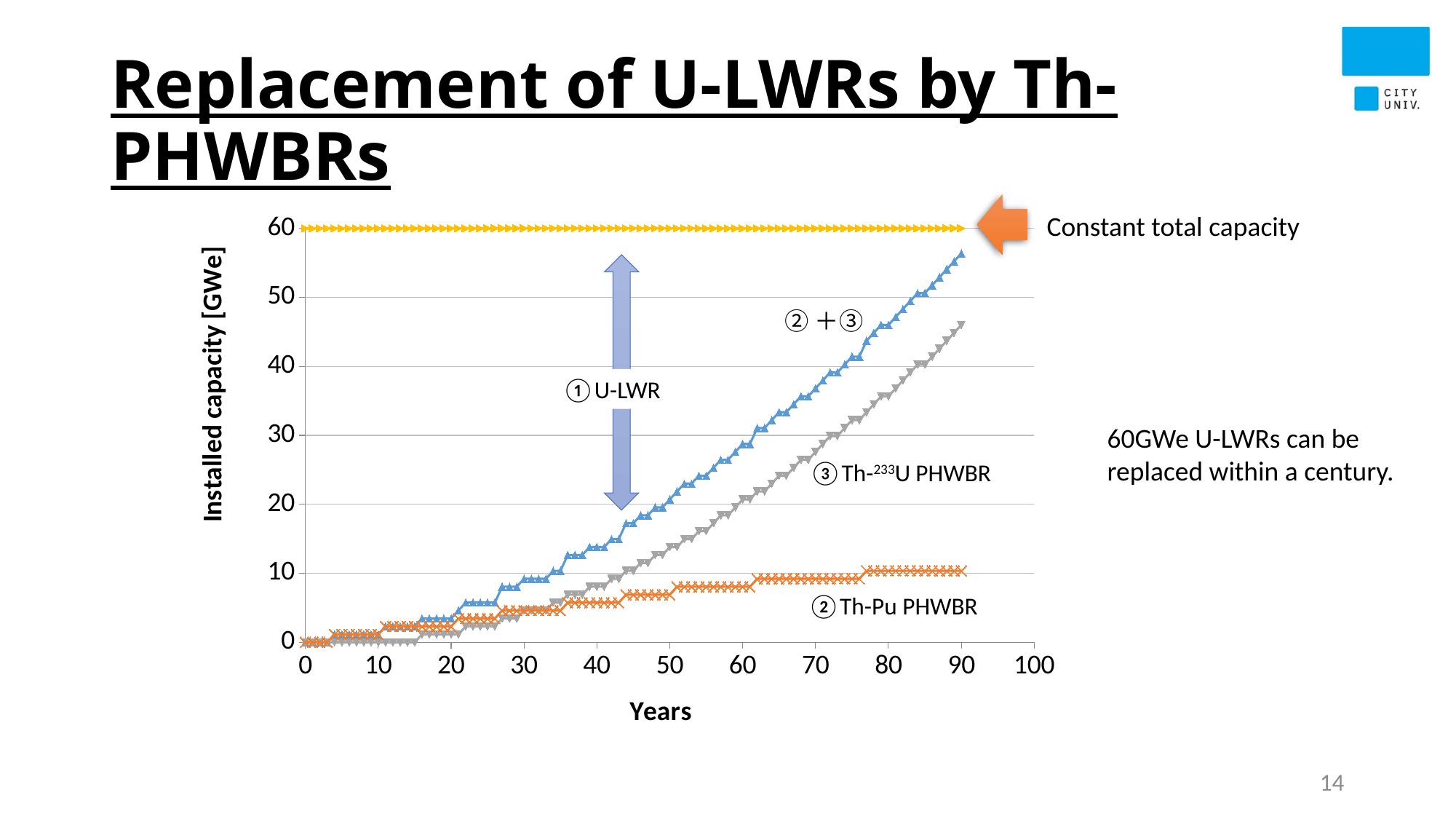
Does the ②+③ series rise or fall as the years increase? rise Is the value of the ③ Th-233U PHWBR series at year 90 greater or less than 40? greater What is the maximum value shown on the x axis of the chart? 100 Is the value of the ② Th-Pu PHWBR series at year 90 greater or less than 20? less Is the value of the ③ Th-233U PHWBR series at year 50 greater or less than 20? less At year 90, which series is larger: ③ Th-233U PHWBR or ② Th-Pu PHWBR? ③ Th-233U PHWBR At what constant value does the 'Constant total capacity' line sit on the y axis? 60 What is the title of the y axis of the chart? Installed capacity [GWe] Which plotted series has the lowest value at year 90? ② Th-Pu PHWBR What kind of chart is shown on the slide? line chart What is the title of the x axis of the chart? Years